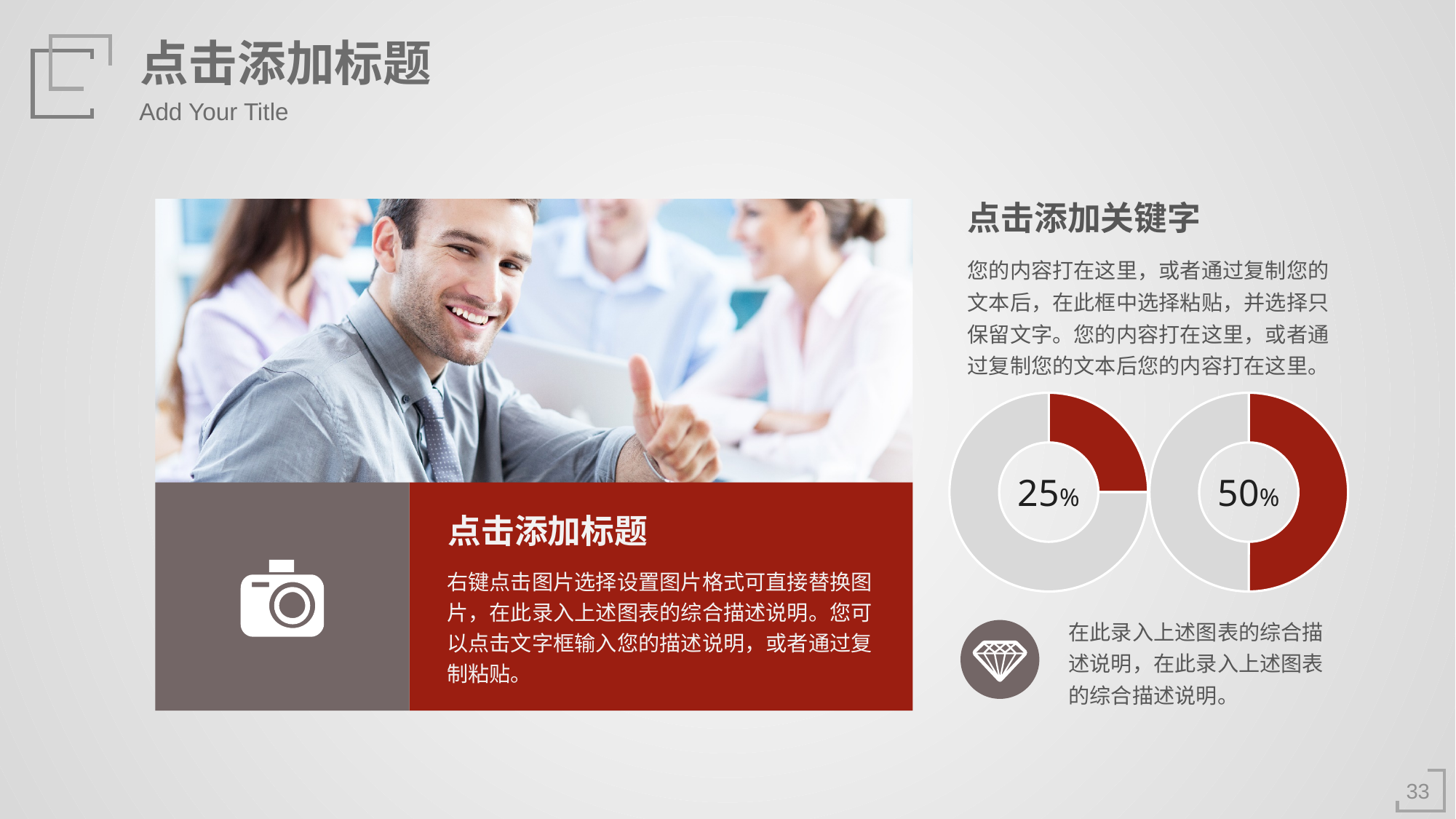
What is the difference between the percentage shown in the right doughnut chart and the percentage shown in the left doughnut chart? 25% In the right doughnut chart, what share of the ring is filled in red? 50% What value is printed in the centre of the right doughnut chart? 50% What kind of chart are the two charts on the right side of the slide? doughnut chart How many doughnut charts are shown on the slide? 2 What value is printed in the centre of the left doughnut chart? 25% Which doughnut chart shows the smaller percentage, the left one or the right one? the left one In the left doughnut chart, what share of the ring is filled in red? 25% What colour is the highlighted segment in each doughnut chart? red Is the value shown in the left doughnut chart greater or less than 50%? less Which doughnut chart shows the larger percentage, the left one or the right one? the right one